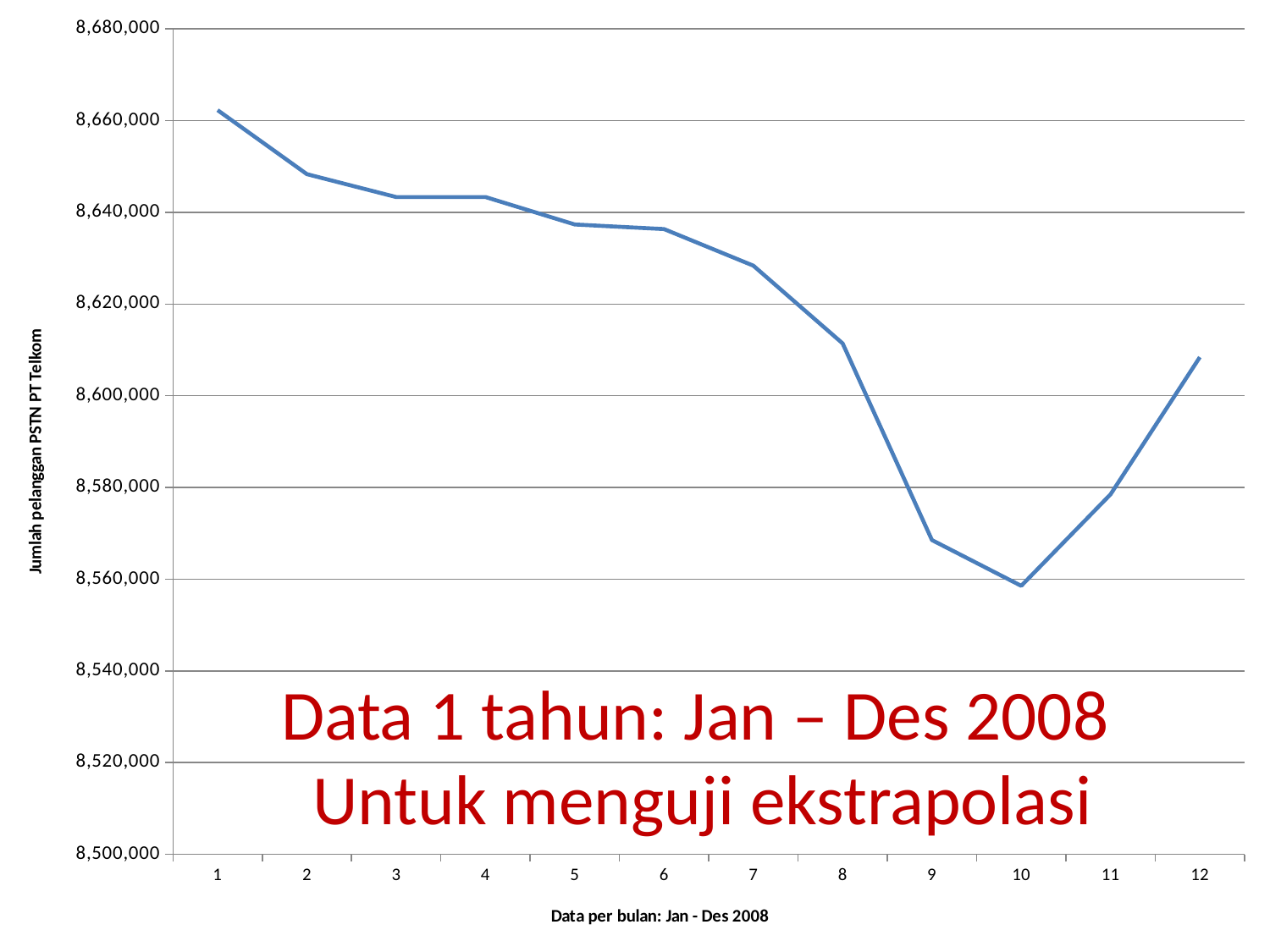
What kind of chart is shown on the slide? line chart Does the line generally rise or fall from month 1 to month 10? fall What is the title of the vertical axis? Jumlah pelanggan PSTN PT Telkom Is the value for month 1 greater or less than 8,640,000? greater Is the value for month 7 greater or less than 8,620,000? greater How many data points (months) are plotted on the x axis? 12 Is the value for month 10 greater or less than 8,580,000? less Which month has the highest number of PSTN subscribers? 1 Which is larger, the value for month 1 or the value for month 12? month 1 Which month has the lowest number of PSTN subscribers? 10